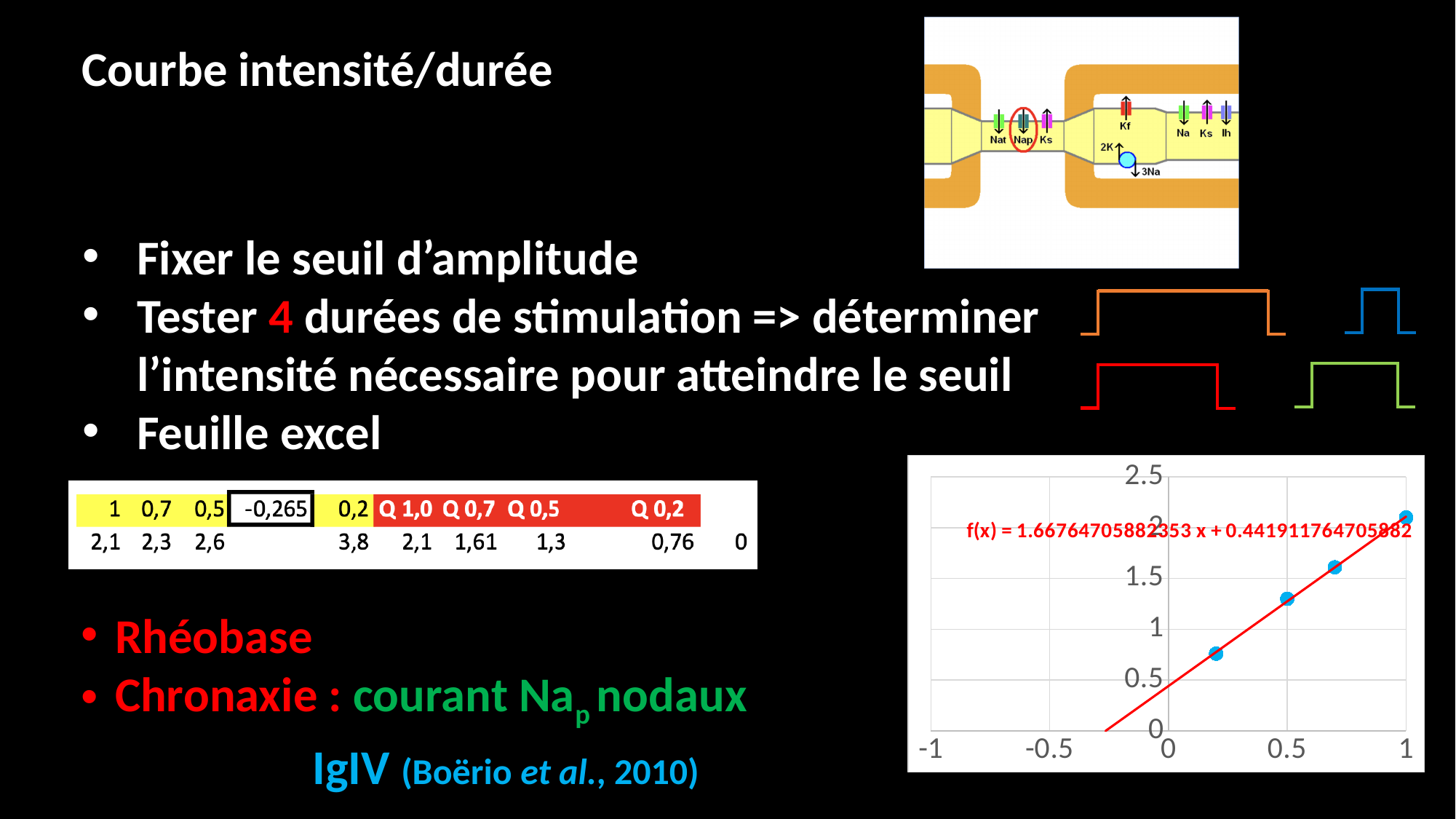
How many data points are plotted on the chart? 4 At which x value is the highest plotted point? 1 Is the value of the point at x = 1 greater or less than 2? greater Is the value of the point at x = 0.7 greater or less than 1.5? greater Do the plotted values rise or fall as x increases? rise What is the equation of the trendline displayed on the chart? f(x) = 1.66764705882353 x + 0.441911764705882 What is the maximum value shown on the y axis? 2.5 Is the value of the point at x = 0.2 greater or less than 1? less What kind of chart is shown on the slide? scatter chart with a linear trendline At which x value is the lowest plotted point? 0.2